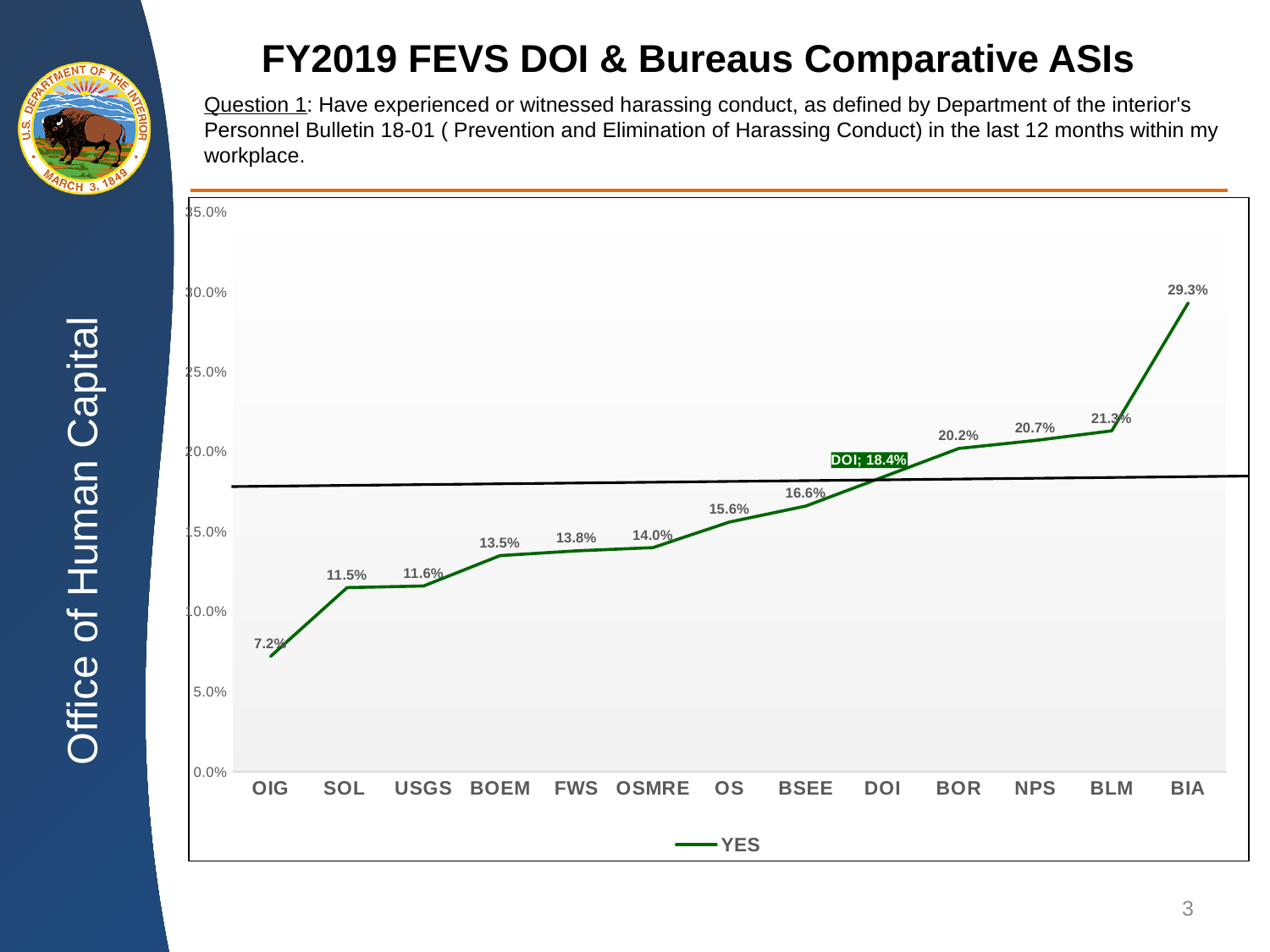
What is the value for OSMRE? 14.0% What is the difference between the values for BIA and BLM? 8.0% What type of chart is shown on the slide? Line chart Which bureau has the lowest value? OIG What is the value for DOI? 18.4% How many categories are plotted on the x axis? 13 Do the values rise or fall moving from left to right along the x axis? Rise What is the value for BIA? 29.3% What is the difference between the values for DOI and OIG? 11.2% How many series does the legend list? 1 Which bureau has the highest value? BIA Which has a larger value, BOR or BSEE? BOR